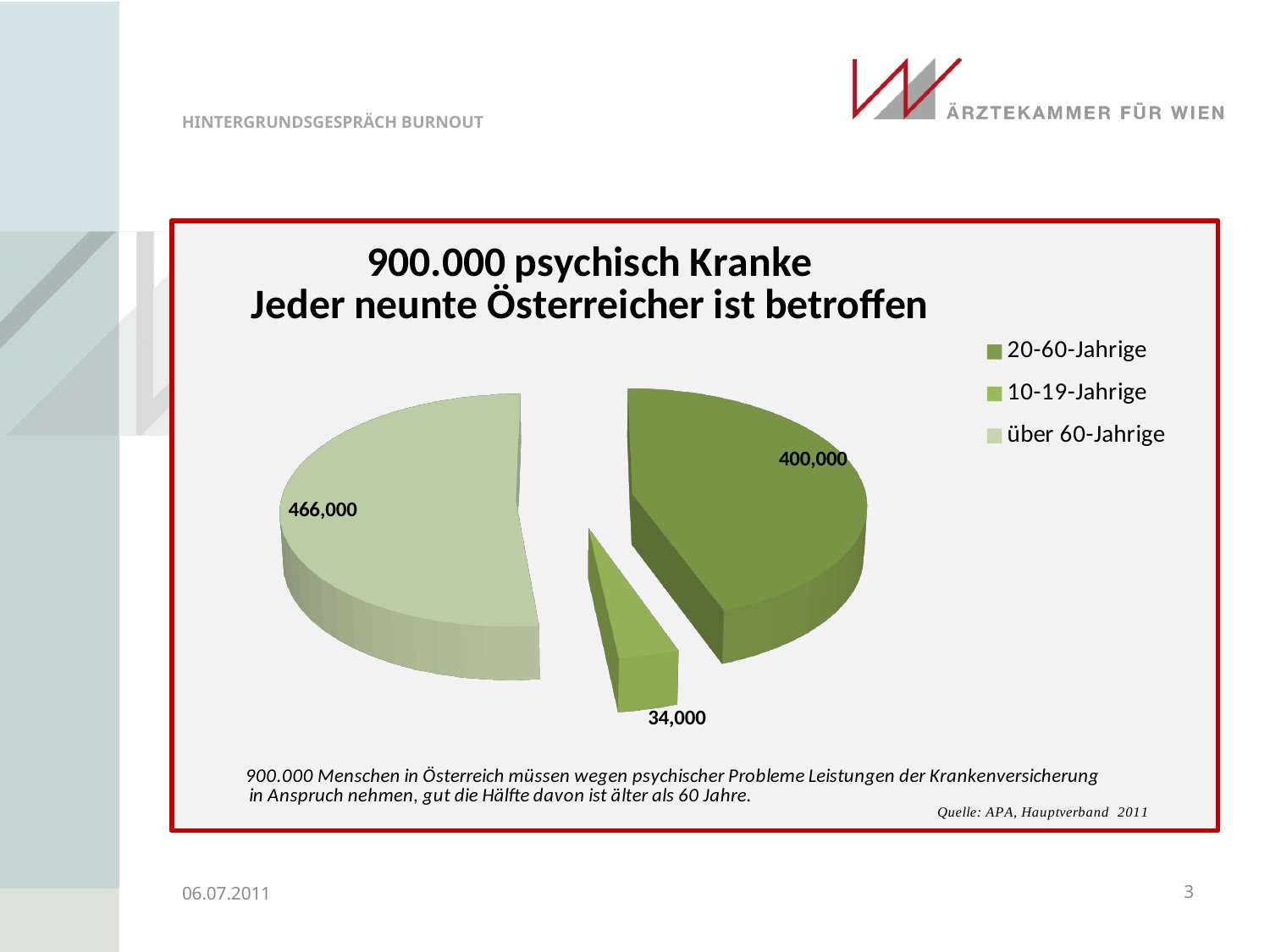
What is the value for the 10-19-Jahrige slice? 34,000 What is the title of the chart? 900.000 psychisch Kranke Jeder neunte Österreicher ist betroffen Which age group has the largest slice? über 60-Jahrige Which age group has the smallest slice? 10-19-Jahrige What is the total of all three slices? 900,000 What is the value for the 20-60-Jahrige slice? 400,000 What is the difference between the 20-60-Jahrige and 10-19-Jahrige values? 366,000 What kind of chart is shown on the slide? Pie chart Which is larger, the value for 20-60-Jahrige or for über 60-Jahrige? über 60-Jahrige What is the difference between the über 60-Jahrige and 20-60-Jahrige values? 66,000 What is the value for the über 60-Jahrige slice? 466,000 How many slices does the pie chart have? 3